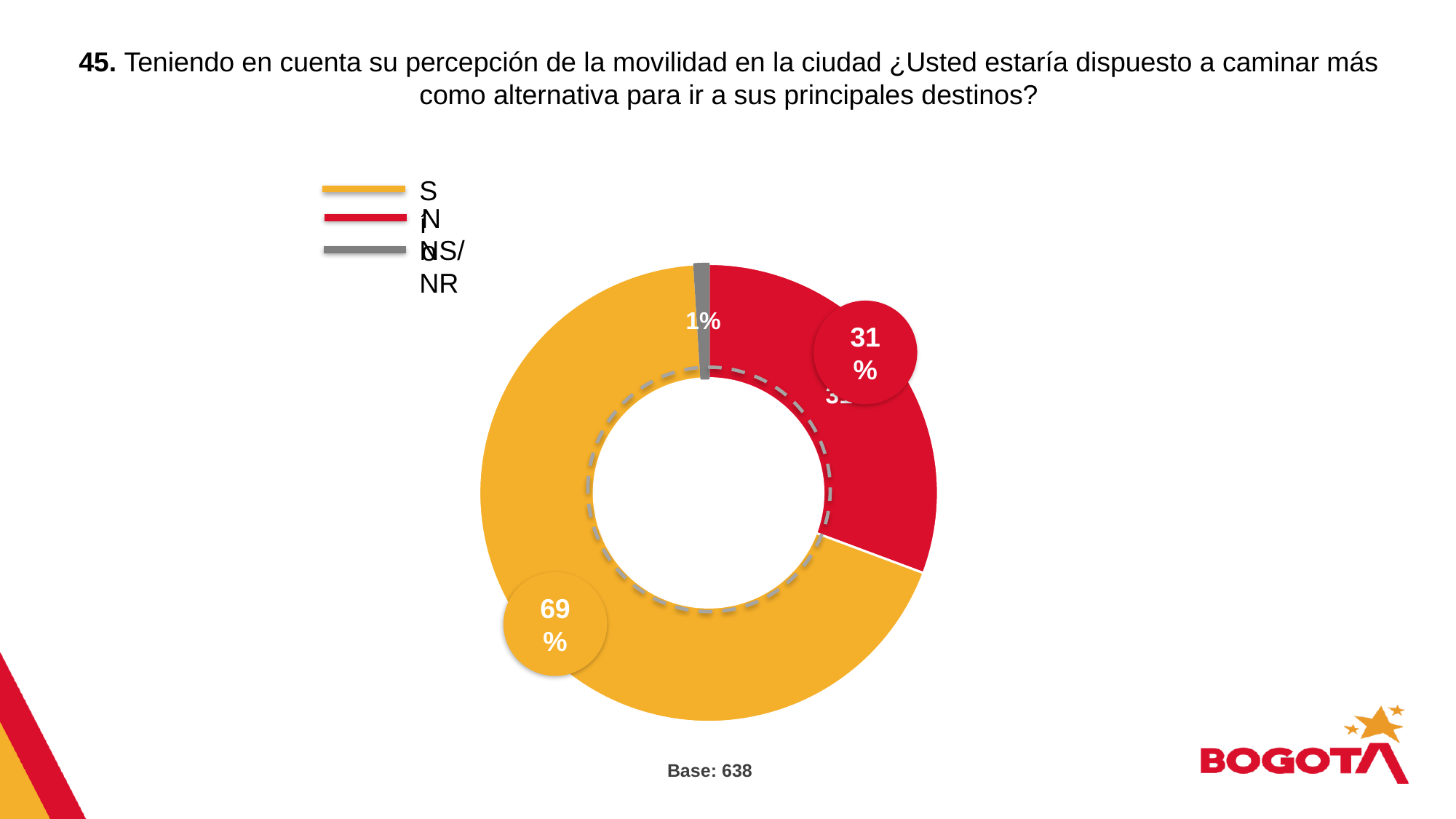
Which response has the largest share of the chart? Sí What is the difference in percentage points between the "Sí" and "No" responses? 38 What percentage of respondents answered "NS/NR"? 1% Which response has the smallest share of the chart? NS/NR How many entries does the legend list? 3 What percentage of respondents answered "No"? 31% What percentage of respondents answered "Sí"? 69% What kind of chart is shown on the slide? Donut (pie) chart What is the base (number of respondents) shown below the chart? 638 What colour represents the "No" response in the chart? Red Which is larger, the share for "No" or the share for "NS/NR"? No How many categories does the chart show? 3